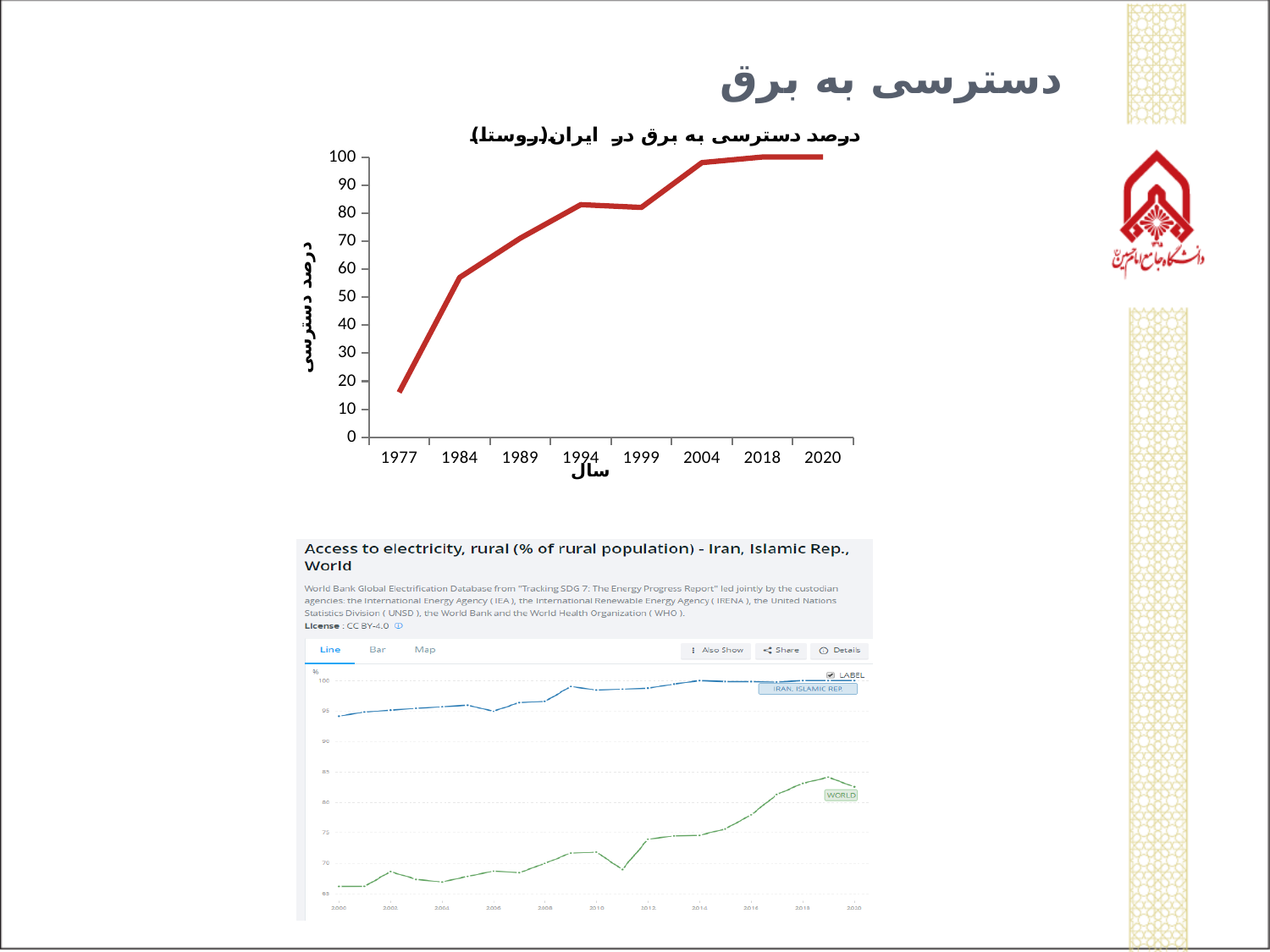
In the top chart, is the value for 1977 greater or less than 20? less In the bottom chart titled 'Access to electricity, rural (% of rural population)', which series has the higher values, Iran, Islamic Rep. or World? Iran, Islamic Rep. In the top chart, is the value for 1994 greater or less than 70? greater In the top chart, do the values rise or fall from 1977 to 2020? rise In the top chart, which is larger, the value for 1984 or the value for 1977? 1984 What kind of chart is the top chart on the slide? line chart In the bottom chart titled 'Access to electricity, rural (% of rural population)', is the World value for 2000 greater or less than 70? less In the top chart, which year has the lowest value? 1977 In the top chart, how many years are marked on the x axis? 8 In the bottom chart titled 'Access to electricity, rural (% of rural population)', how many series are shown? 2